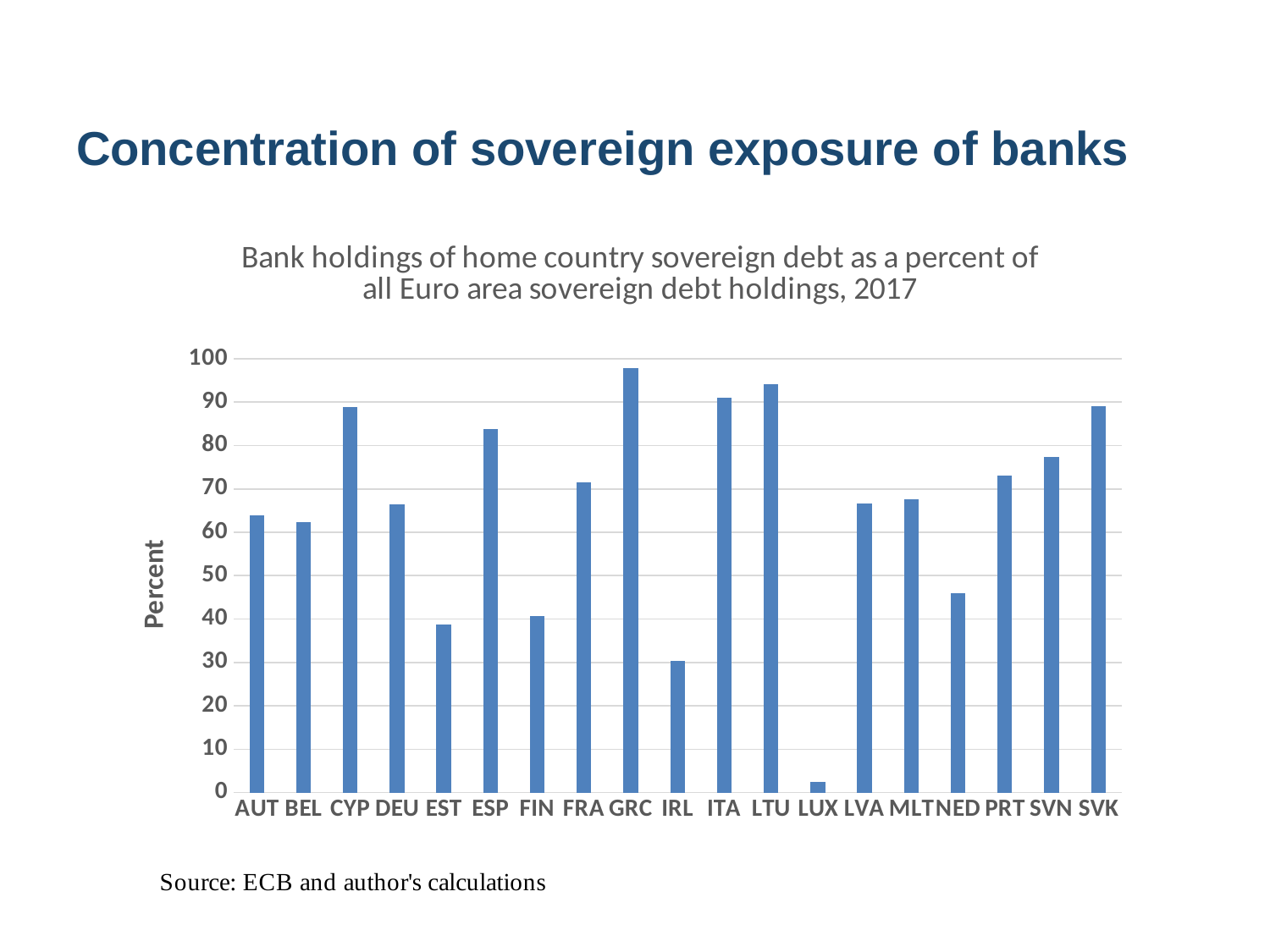
Which country has the lowest value in the chart? LUX What year does the chart title say the data refers to? 2017 Which is larger, the value for CYP or the value for DEU? CYP What kind of chart is shown on the slide? bar chart Is the value for NED greater or less than 50? less Which country has the highest bank holdings of home country sovereign debt as a percent of all Euro area sovereign debt holdings? GRC What is the label on the vertical axis of the chart? Percent Is the value for EST greater or less than 40? less How many countries are shown on the x axis of the chart? 19 Is the value for ESP greater or less than 80? greater Which is larger, the value for IRL or the value for EST? EST